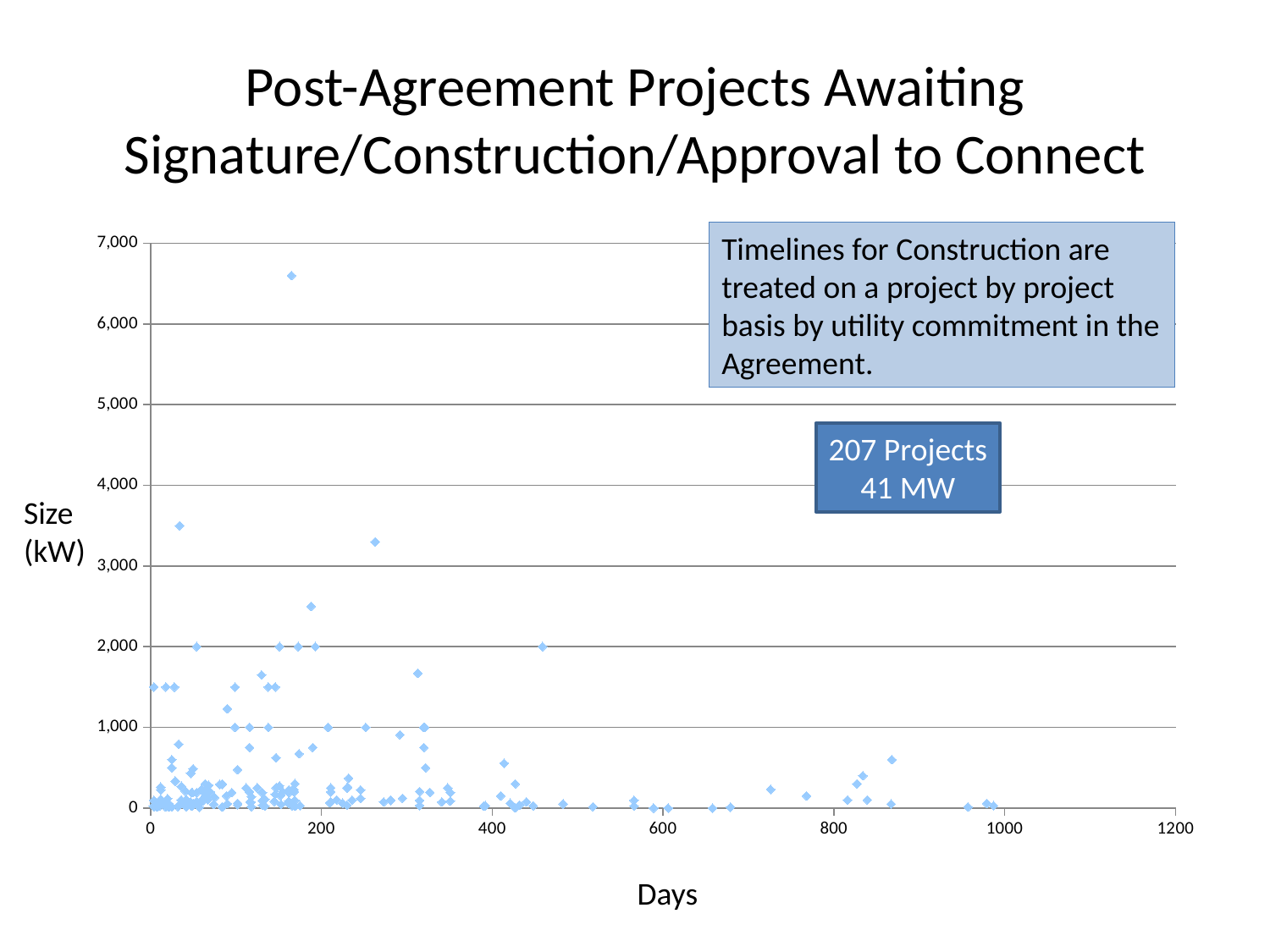
Is the size of the point plotted near 260 days greater or less than 3,000 kW? greater What kind of chart is shown on the slide? scatter chart Is the size of the highest point on the chart greater or less than 6,000 kW? greater Is the size of the point plotted near 35 days greater or less than 3,000 kW? greater What is the title of the horizontal axis of the chart? Days What total capacity does the slide state for the plotted projects? 41 MW What is the title of the vertical axis of the chart? Size (kW) How many projects does the slide say are represented in the chart? 207